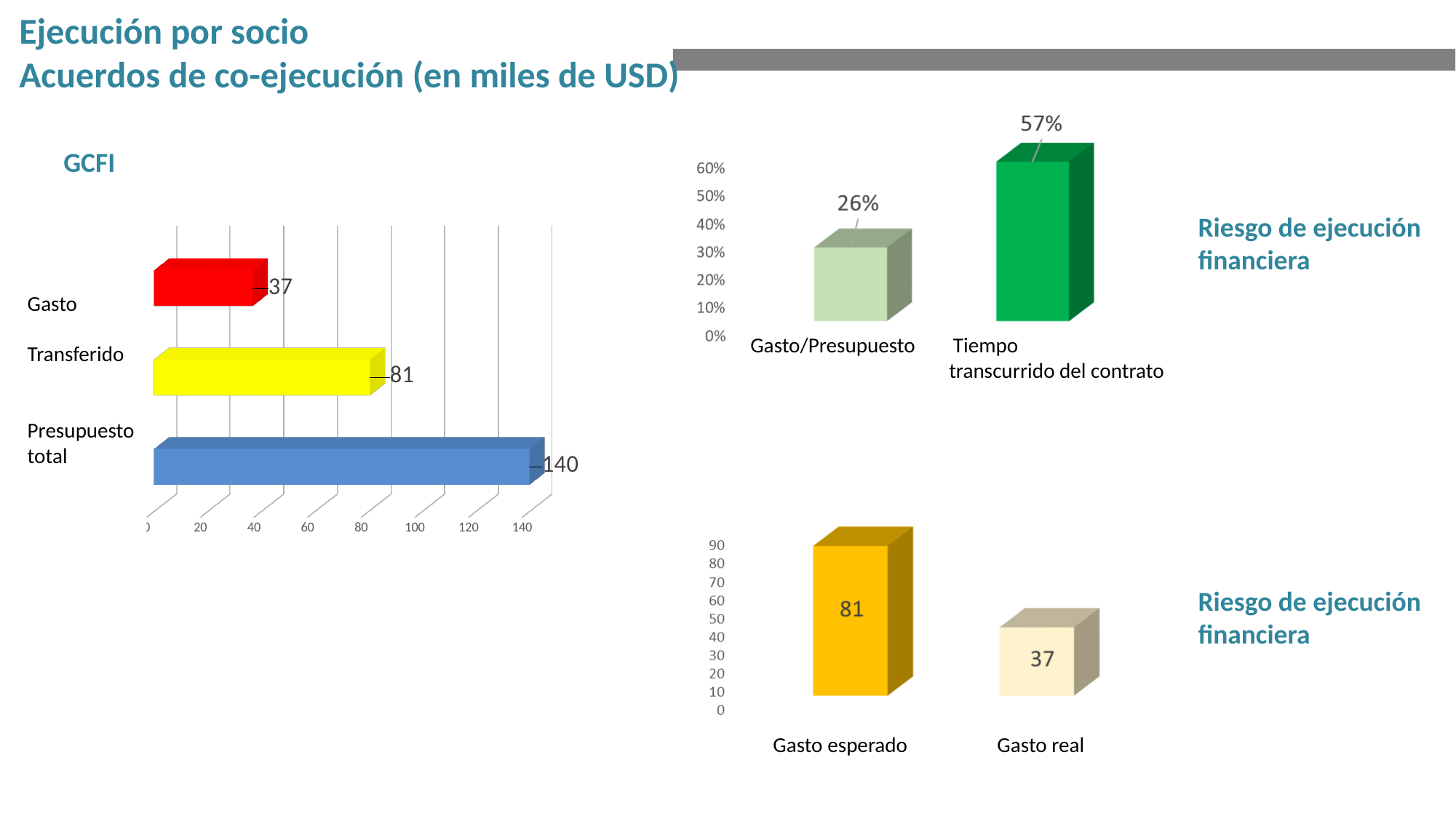
In the GCFI chart on the left, how many categories are shown? 3 What kind of chart is the GCFI chart on the left? Bar chart In the top-right chart, what is the value for Gasto/Presupuesto? 26% In the GCFI chart on the left, what is the value for Gasto? 37 In the top-right chart, what is the value for Tiempo transcurrido del contrato? 57% In the bottom-right chart, what is the difference between Gasto esperado and Gasto real? 44 In the GCFI chart on the left, what is the value for Presupuesto total? 140 In the GCFI chart on the left, which category has the highest value? Presupuesto total In the bottom-right chart, which is larger, Gasto esperado or Gasto real? Gasto esperado In the GCFI chart on the left, what is the value for Transferido? 81 In the GCFI chart on the left, what is the difference between Presupuesto total and Transferido? 59 In the GCFI chart on the left, which category has the lowest value? Gasto